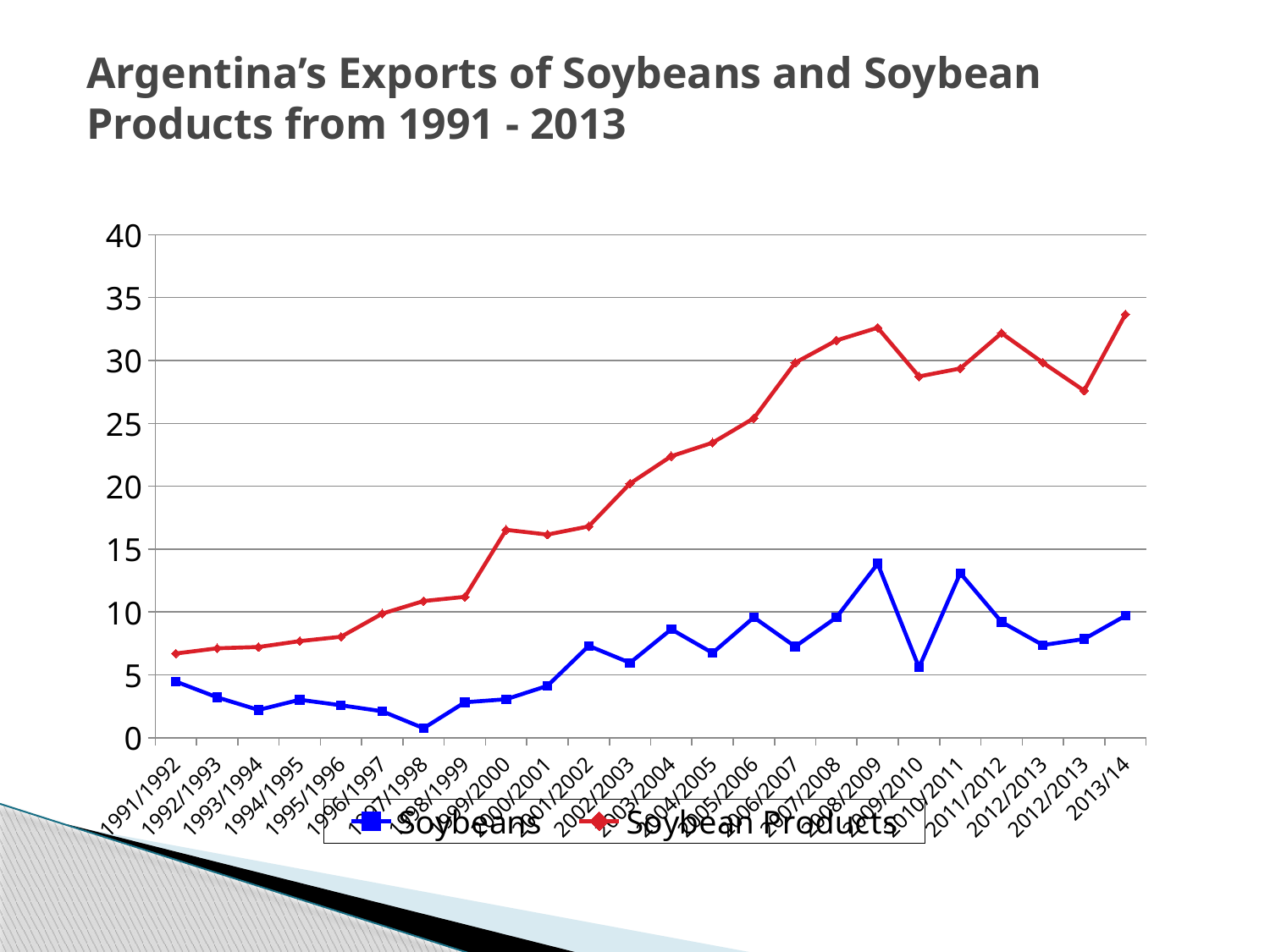
Which series is drawn in red? Soybean Products In which season does the Soybean Products series reach its highest value? 2013/14 How many series does the legend list? 2 In which season does the Soybean Products series have its lowest value? 1991/1992 Is the value for Soybean Products in 2013/14 greater or less than 30? greater Is the value for Soybean Products in 1991/1992 greater or less than 10? less Is the value for Soybeans in 1997/1998 greater or less than 5? less What kind of chart is shown on the slide? line chart In which season does the Soybeans series reach its lowest value? 1997/1998 Which series has the larger value in 2013/14, Soybeans or Soybean Products? Soybean Products What are the two series named in the legend? Soybeans and Soybean Products